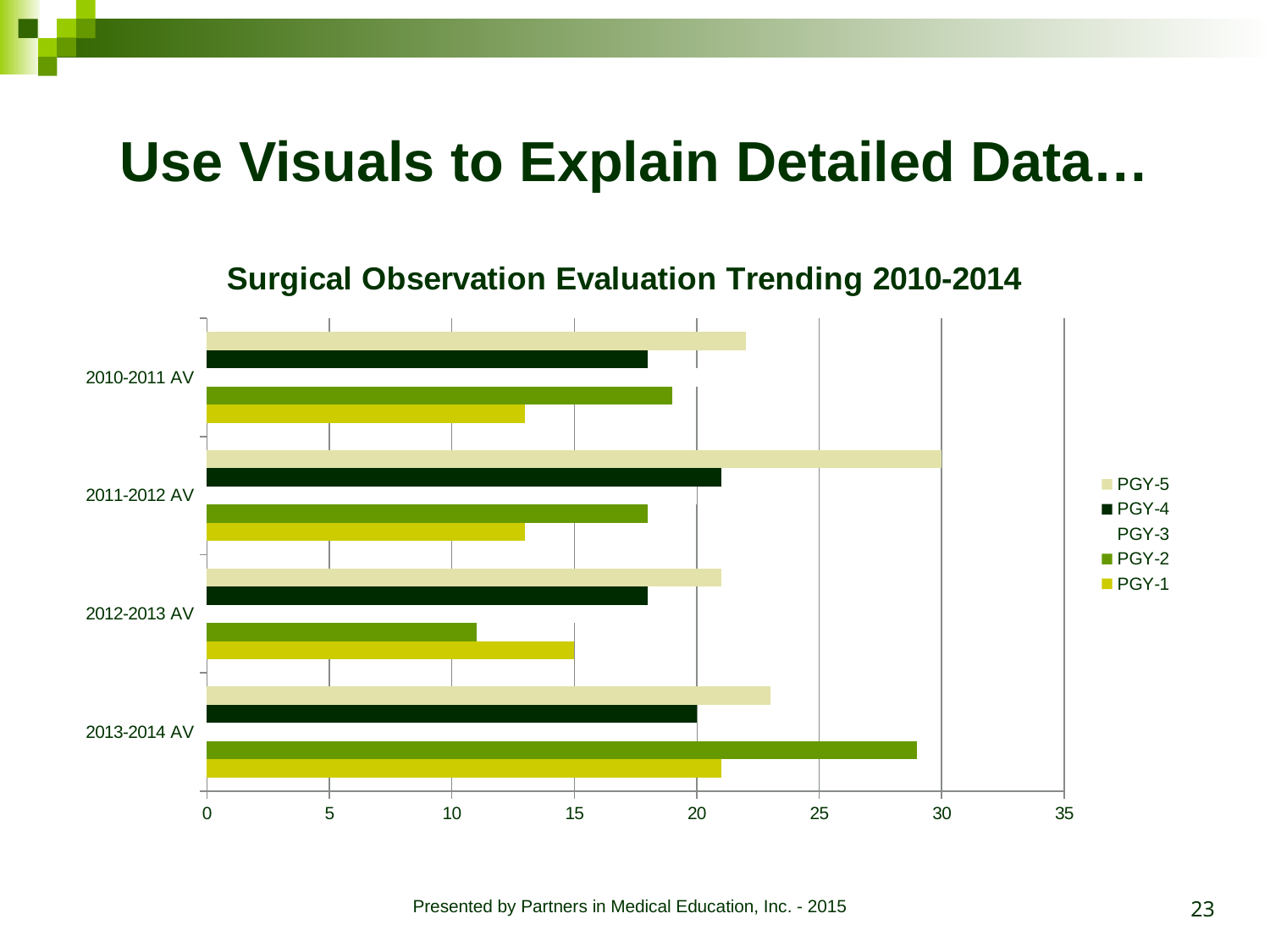
Which academic year has the lowest PGY-2 value? 2012-2013 AV Is the PGY-1 value for 2010-2011 AV greater or less than 15? less What is the title of the chart? Surgical Observation Evaluation Trending 2010-2014 How many academic-year categories are shown on the chart? 4 What type of chart is shown on the slide? Bar chart Which is larger: the PGY-2 value for 2013-2014 AV or the PGY-2 value for 2010-2011 AV? 2013-2014 AV Is the PGY-2 value for 2013-2014 AV greater or less than 25? greater What is the PGY-4 value for 2013-2014 AV? 20 What is the PGY-5 value for 2011-2012 AV? 30 How many series does the legend list? 5 What is the PGY-1 value for 2012-2013 AV? 15 Which academic year has the highest PGY-5 value? 2011-2012 AV